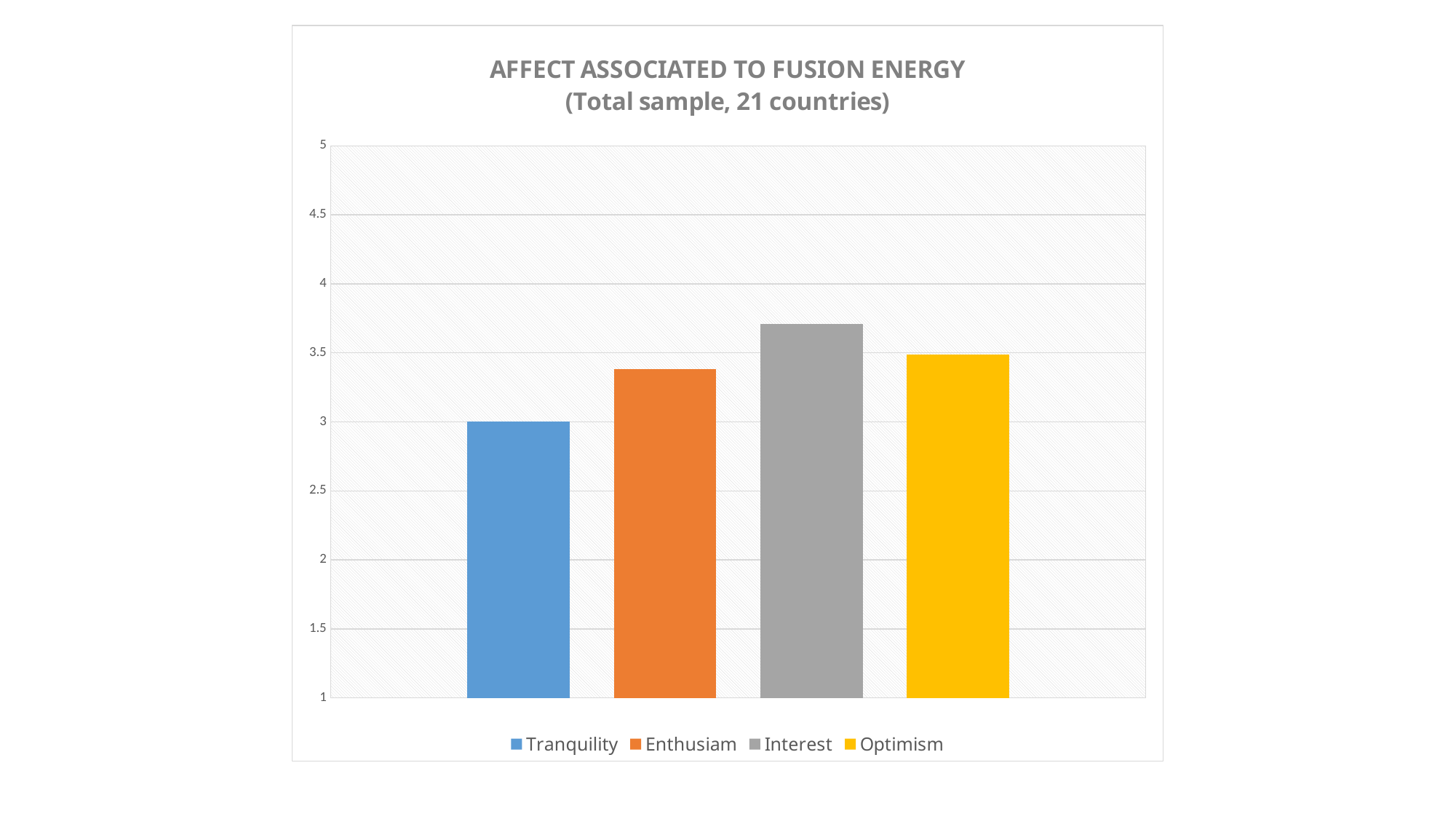
How many bars are plotted in the chart? 4 What is the title of the chart? AFFECT ASSOCIATED TO FUSION ENERGY (Total sample, 21 countries) Which is larger, the value for Optimism or the value for Tranquility? Optimism Which affect has the lowest value? Tranquility Which affect has the highest value? Interest Is the value for Enthusiam greater or less than 3.5? less Is the value for Tranquility greater or less than 2.5? greater What colour is the bar for Optimism? yellow Is the value for Interest greater or less than 3.5? greater Which is larger, the value for Interest or the value for Enthusiam? Interest How many series does the legend list? 4 What kind of chart is shown on the slide? bar chart